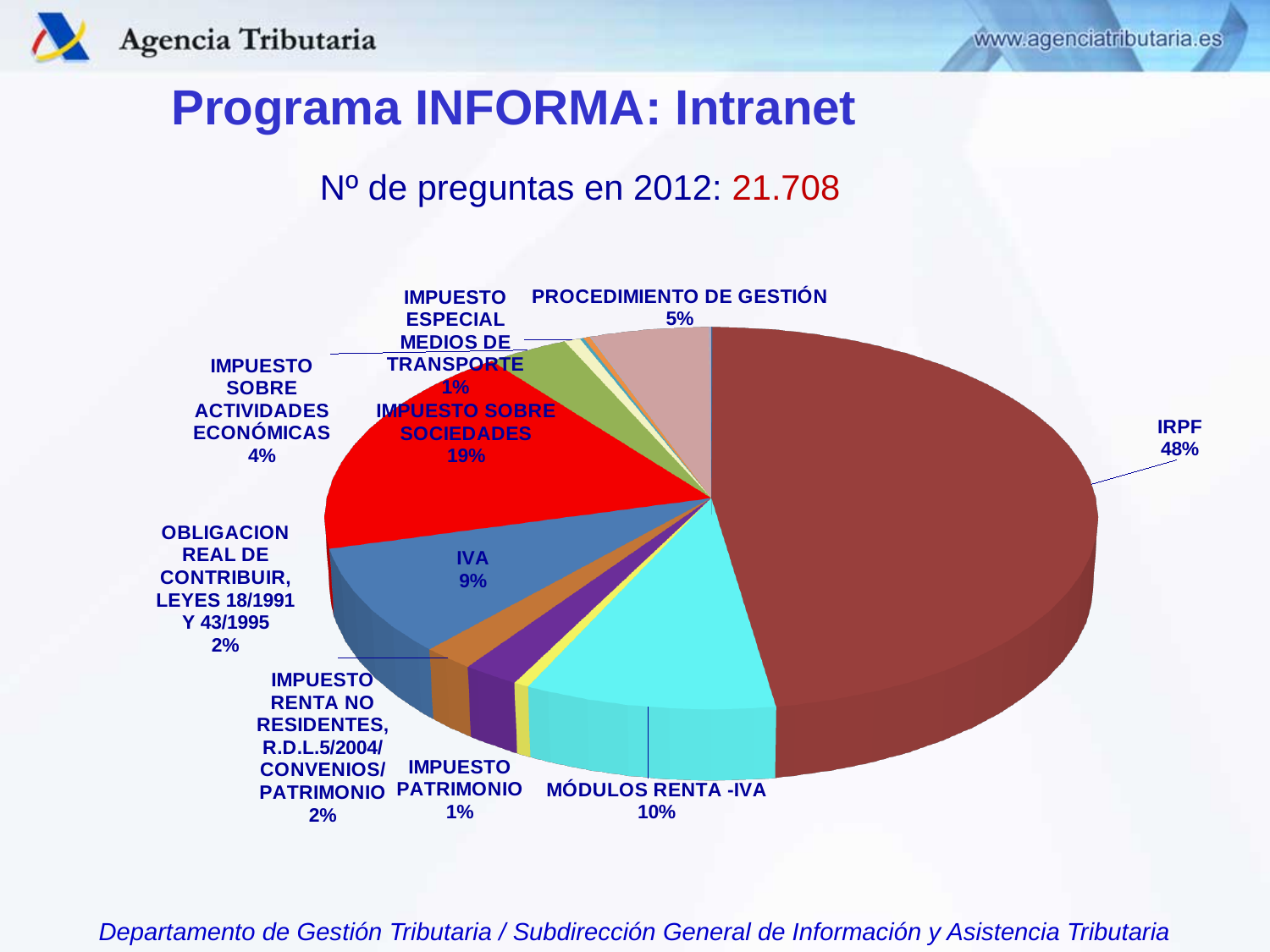
Which has a larger share, IVA or MÓDULOS RENTA -IVA? MÓDULOS RENTA -IVA What share of the pie does IRPF represent? 48% According to the slide, what was the total number of questions (Nº de preguntas) in 2012? 21.708 What percentage is shown for PROCEDIMIENTO DE GESTIÓN? 5% What percentage is shown for IMPUESTO SOBRE ACTIVIDADES ECONÓMICAS? 4% Which category has the largest share of the pie? IRPF What percentage is shown for MÓDULOS RENTA -IVA? 10% Which has a larger share, IMPUESTO SOBRE ACTIVIDADES ECONÓMICAS or PROCEDIMIENTO DE GESTIÓN? PROCEDIMIENTO DE GESTIÓN What percentage is shown for IMPUESTO SOBRE SOCIEDADES? 19% What percentage is shown for IVA? 9% What kind of chart is shown on the slide? Pie chart What is the difference in percentage points between IRPF and IMPUESTO SOBRE SOCIEDADES? 29 percentage points